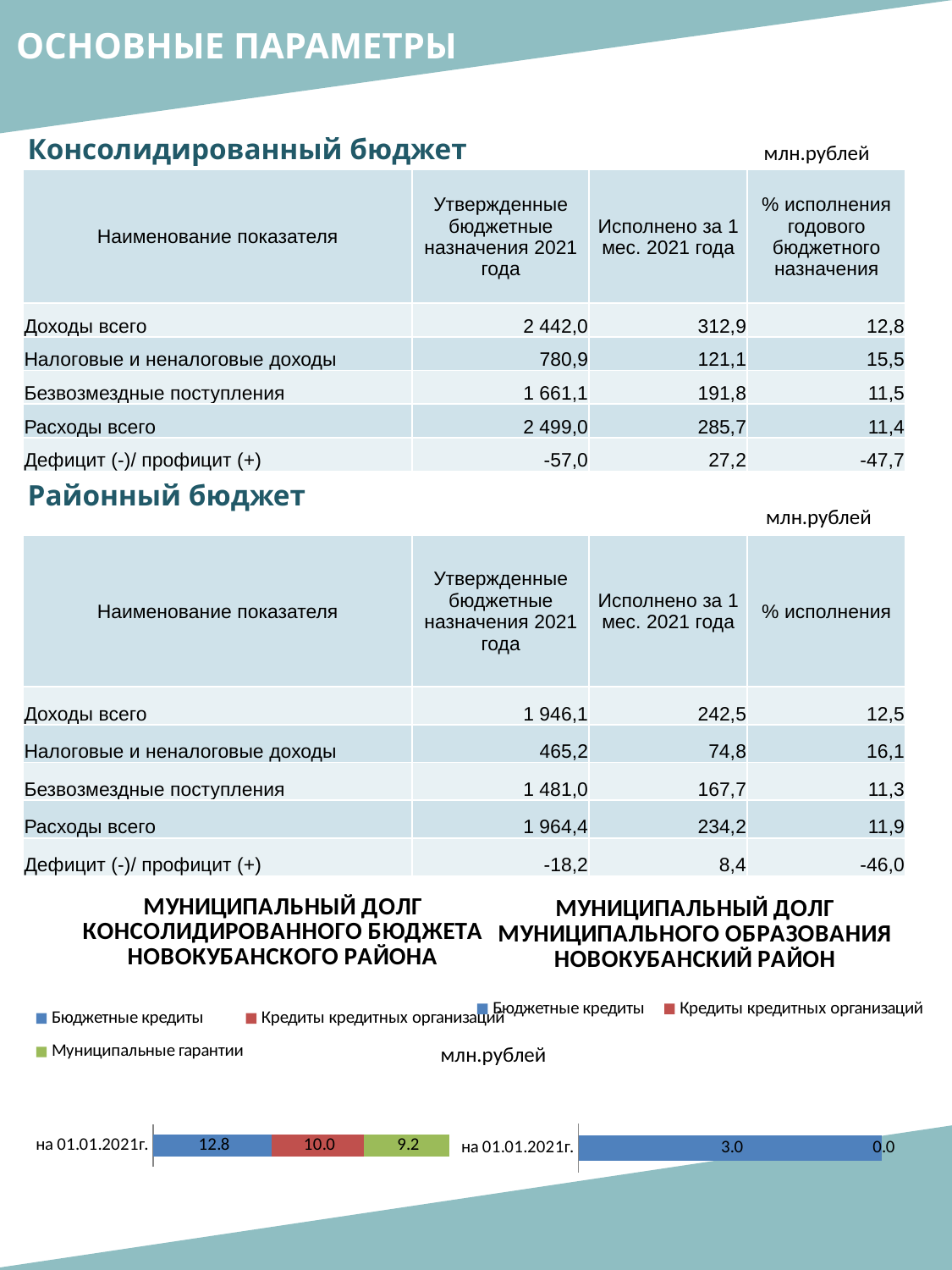
What kind of chart is the left chart (Муниципальный долг консолидированного бюджета Новокубанского района)? Stacked bar chart In the right chart (Муниципальный долг муниципального образования Новокубанский район), what is the value for Кредиты кредитных организаций? 0.0 In the left chart (Муниципальный долг консолидированного бюджета Новокубанского района), which series has the highest value? Бюджетные кредиты In the right chart (Муниципальный долг муниципального образования Новокубанский район), what is the value for Бюджетные кредиты? 3.0 In the left chart (Муниципальный долг консолидированного бюджета Новокубанского района), what is the value for Кредиты кредитных организаций? 10.0 In the left chart (Муниципальный долг консолидированного бюджета Новокубанского района), what is the value for Муниципальные гарантии? 9.2 In the left chart (Муниципальный долг консолидированного бюджета Новокубанского района), what is the total of the stacked bar for 01.01.2021? 32.0 How many series does the legend of the left chart (Муниципальный долг консолидированного бюджета Новокубанского района) list? 3 In the left chart (Муниципальный долг консолидированного бюджета Новокубанского района), what is the difference between Бюджетные кредиты and Муниципальные гарантии? 3.6 In the left chart (Муниципальный долг консолидированного бюджета Новокубанского района), which series has the lowest value? Муниципальные гарантии In the left chart (Муниципальный долг консолидированного бюджета Новокубанского района), what is the value for Бюджетные кредиты on 01.01.2021? 12.8 How many series does the legend of the right chart (Муниципальный долг муниципального образования Новокубанский район) list? 2